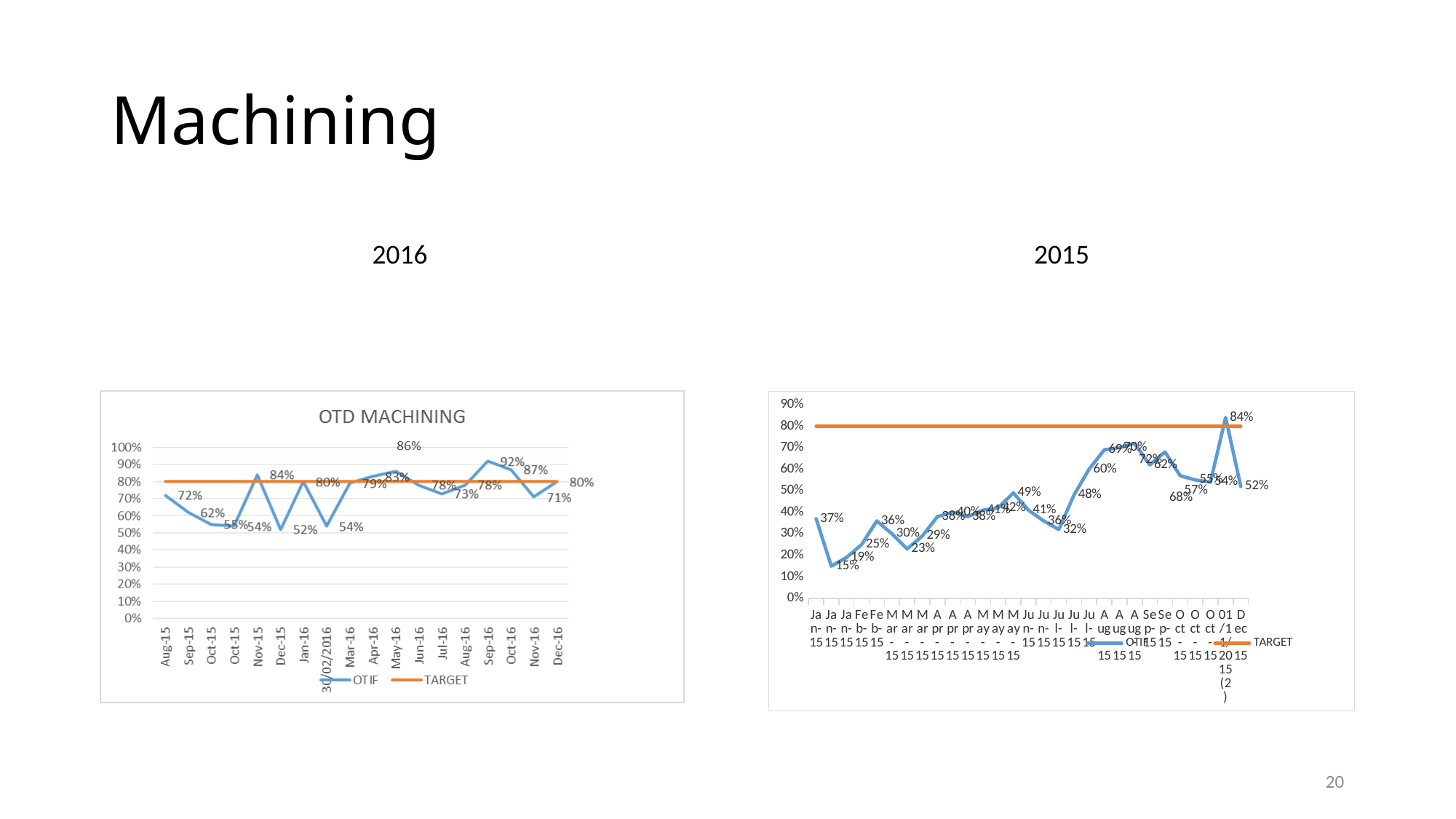
What are the two legend entries in the 2015 chart on the right? OTIF and TARGET In the OTD MACHINING chart on the left, what is the OTIF value for May-16? 86% In the 2015 chart on the right, what is the highest OTIF value shown? 84% In the OTD MACHINING chart on the left, at what level is the TARGET line drawn? 80% In the OTD MACHINING chart on the left, which month has the highest OTIF value? Sep-16 What kind of chart is the OTD MACHINING chart on the left? Line chart In the OTD MACHINING chart on the left, which is higher, the OTIF value for Nov-15 or for Dec-15? Nov-15 How many series does the legend of the OTD MACHINING chart on the left list? 2 In the OTD MACHINING chart on the left, which month has the lowest OTIF value? Dec-15 In the 2015 chart on the right, what is the lowest OTIF value shown? 15% In the OTD MACHINING chart on the left, what is the difference between the OTIF values for Sep-16 and Oct-16? 5 percentage points In the OTD MACHINING chart on the left, what is the OTIF value for Sep-16? 92%